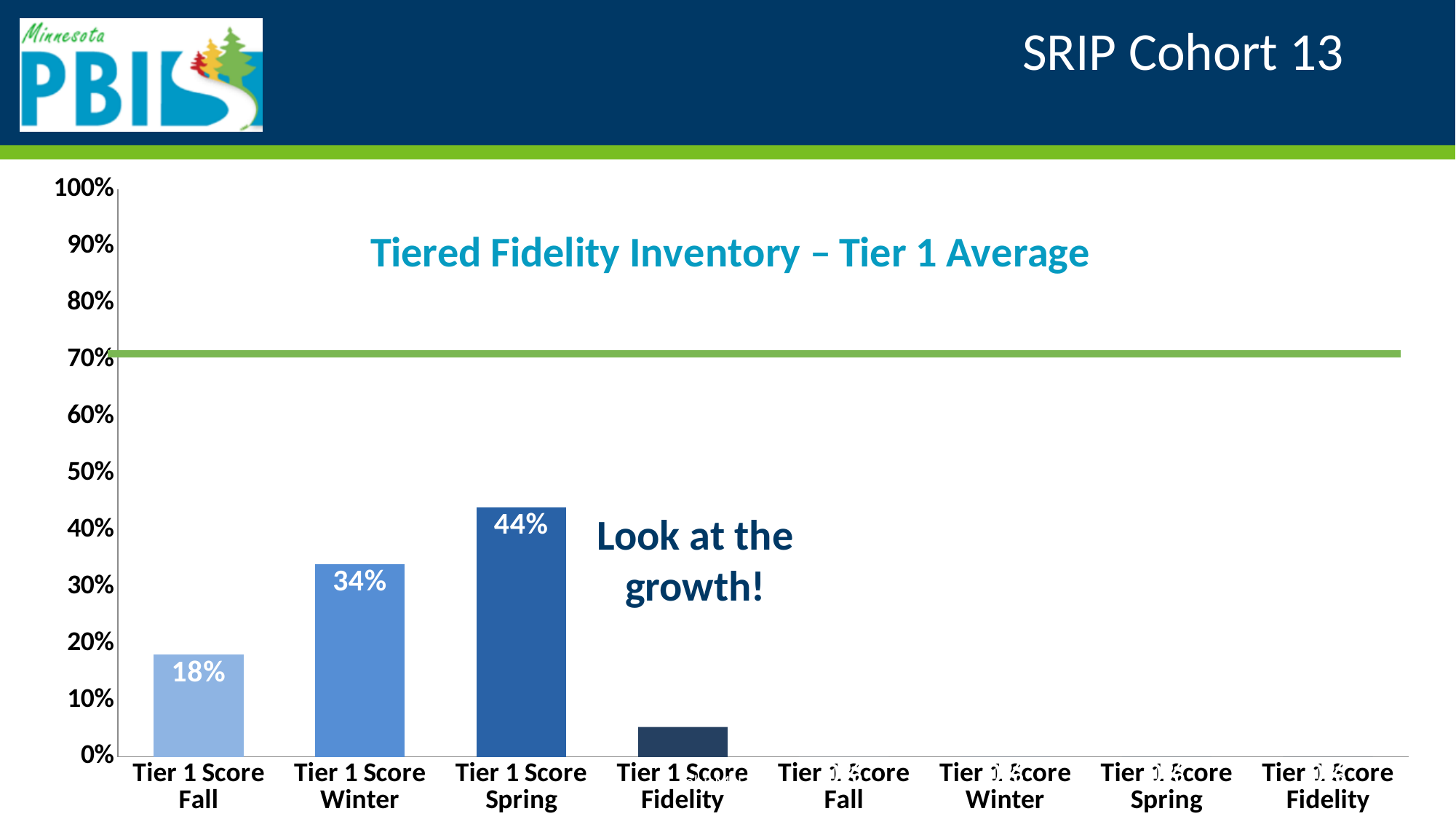
Which is larger, Tier 1 Score Winter or Tier 1 Score Spring? Tier 1 Score Spring What is the value for Tier 1 Score Fall? 18% What is the value for Tier 1 Score Winter? 34% What is the difference between the Tier 1 Score Spring and Tier 1 Score Fall values? 26% What is the difference between the Tier 1 Score Winter and Tier 1 Score Fall values? 16% Do the values rise or fall from Tier 1 Score Fall to Tier 1 Score Spring? rise What is the value for Tier 1 Score Spring? 44% What is the title of the chart? Tiered Fidelity Inventory – Tier 1 Average Which category has the lowest bar? Tier 1 Score Fidelity Which category has the highest value? Tier 1 Score Spring Is the value for Tier 1 Score Fidelity greater or less than 10%? less What kind of chart is shown on the slide? bar chart